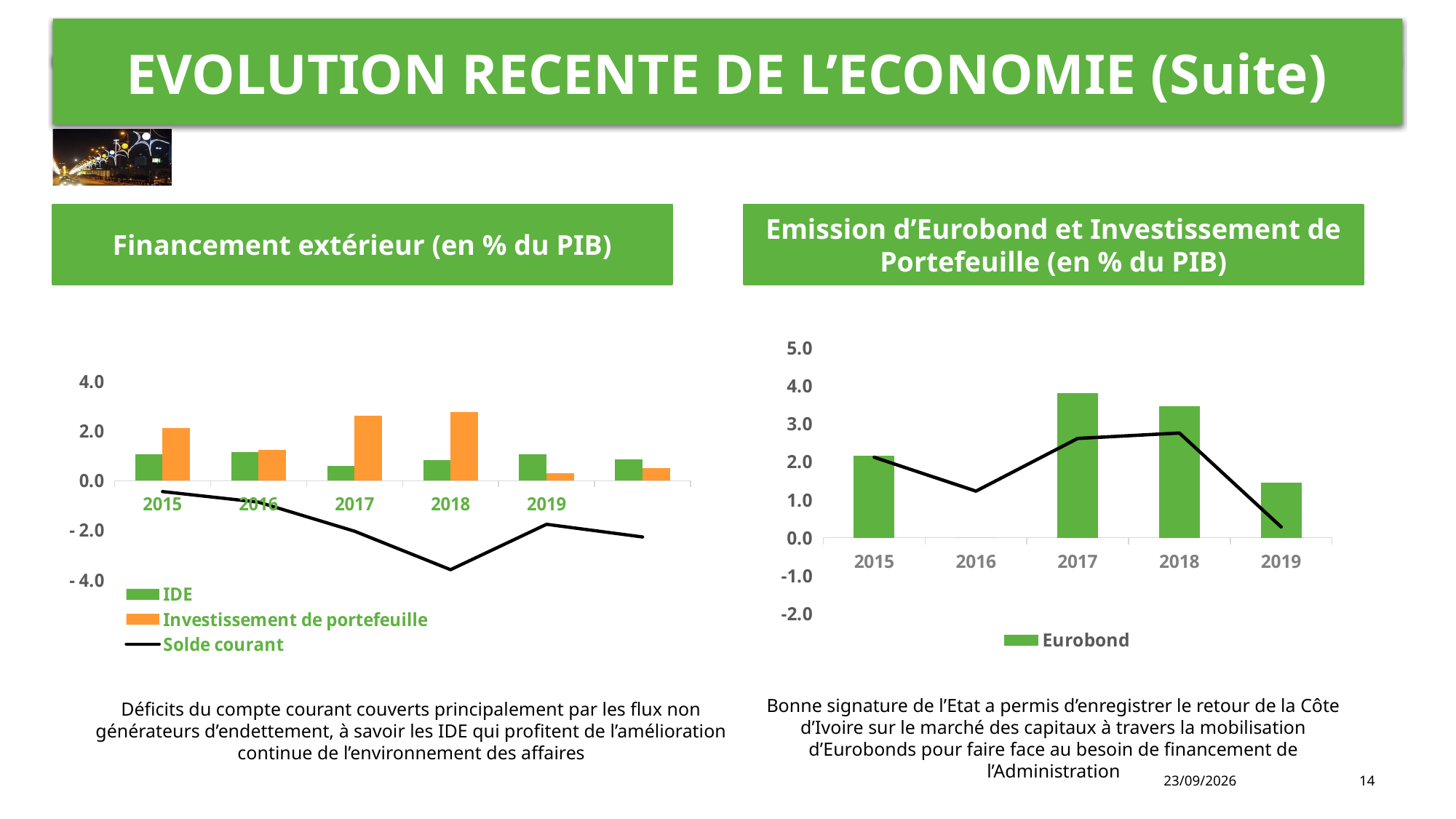
In the 'Financement extérieur (en % du PIB)' chart, is the Investissement de portefeuille value for 2017 greater or less than 2.0? greater In the 'Financement extérieur (en % du PIB)' chart, in which year is the Solde courant line at its lowest? 2018 In the 'Emission d'Eurobond et Investissement de Portefeuille' chart, is the Eurobond value for 2018 greater or less than 3.0? greater In the 'Emission d'Eurobond et Investissement de Portefeuille' chart, how many years are labeled on the x axis? 5 In the 'Financement extérieur (en % du PIB)' chart, how many series does the legend list? 3 In the 'Financement extérieur (en % du PIB)' chart, is the Solde courant value for 2018 greater or less than -2.0? less In the 'Emission d'Eurobond et Investissement de Portefeuille' chart, which year has the lowest Eurobond value? 2016 In the 'Financement extérieur (en % du PIB)' chart, in 2019 which is larger, IDE or Investissement de portefeuille? IDE In the 'Financement extérieur (en % du PIB)' chart, which series is drawn as a line rather than bars? Solde courant In the 'Emission d'Eurobond et Investissement de Portefeuille' chart, which year has the highest Eurobond bar? 2017 In the 'Financement extérieur (en % du PIB)' chart, in 2018 which is larger, IDE or Investissement de portefeuille? Investissement de portefeuille